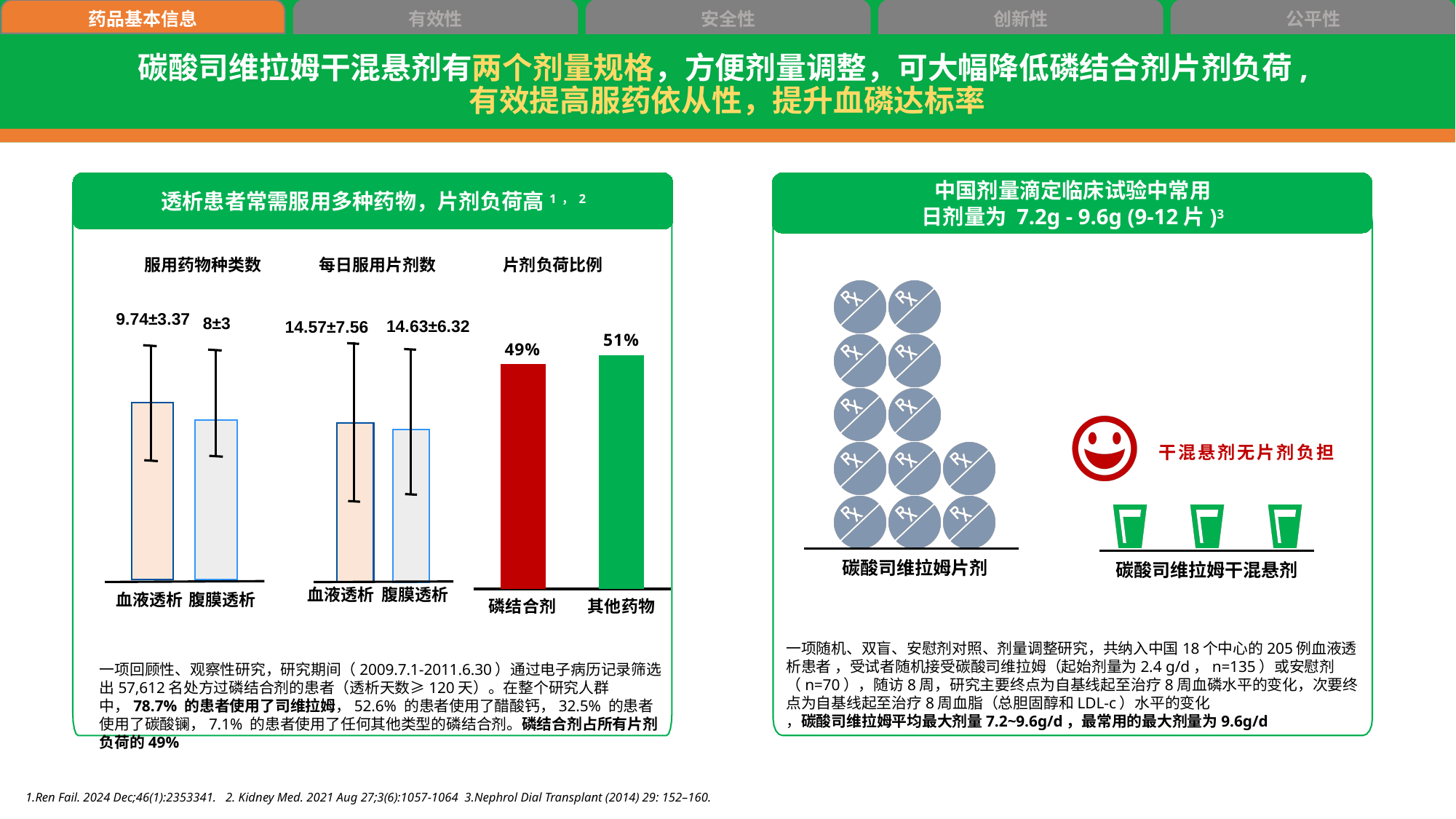
In the chart titled 片剂负荷比例, what colour is the bar for 磷结合剂? Red What type of chart is the one titled 每日服用片剂数? Bar chart In the chart titled 服用药物种类数, which category has the higher mean value, 血液透析 or 腹膜透析? 血液透析 In the chart titled 片剂负荷比例, what percentage is shown for 其他药物? 51% How many categories are shown in the chart titled 片剂负荷比例? 2 In the chart titled 片剂负荷比例, what percentage is shown for 磷结合剂? 49% In the chart titled 服用药物种类数, what is the value shown for 血液透析? 9.74±3.37 In the chart titled 片剂负荷比例, which category has the higher value? 其他药物 In the chart titled 每日服用片剂数, what is the value shown for 腹膜透析? 14.63±6.32 In the chart titled 每日服用片剂数, what is the value shown for 血液透析? 14.57±7.56 In the chart titled 服用药物种类数, what is the value shown for 腹膜透析? 8±3 In the chart titled 片剂负荷比例, what is the difference between the 其他药物 and 磷结合剂 values? 2%